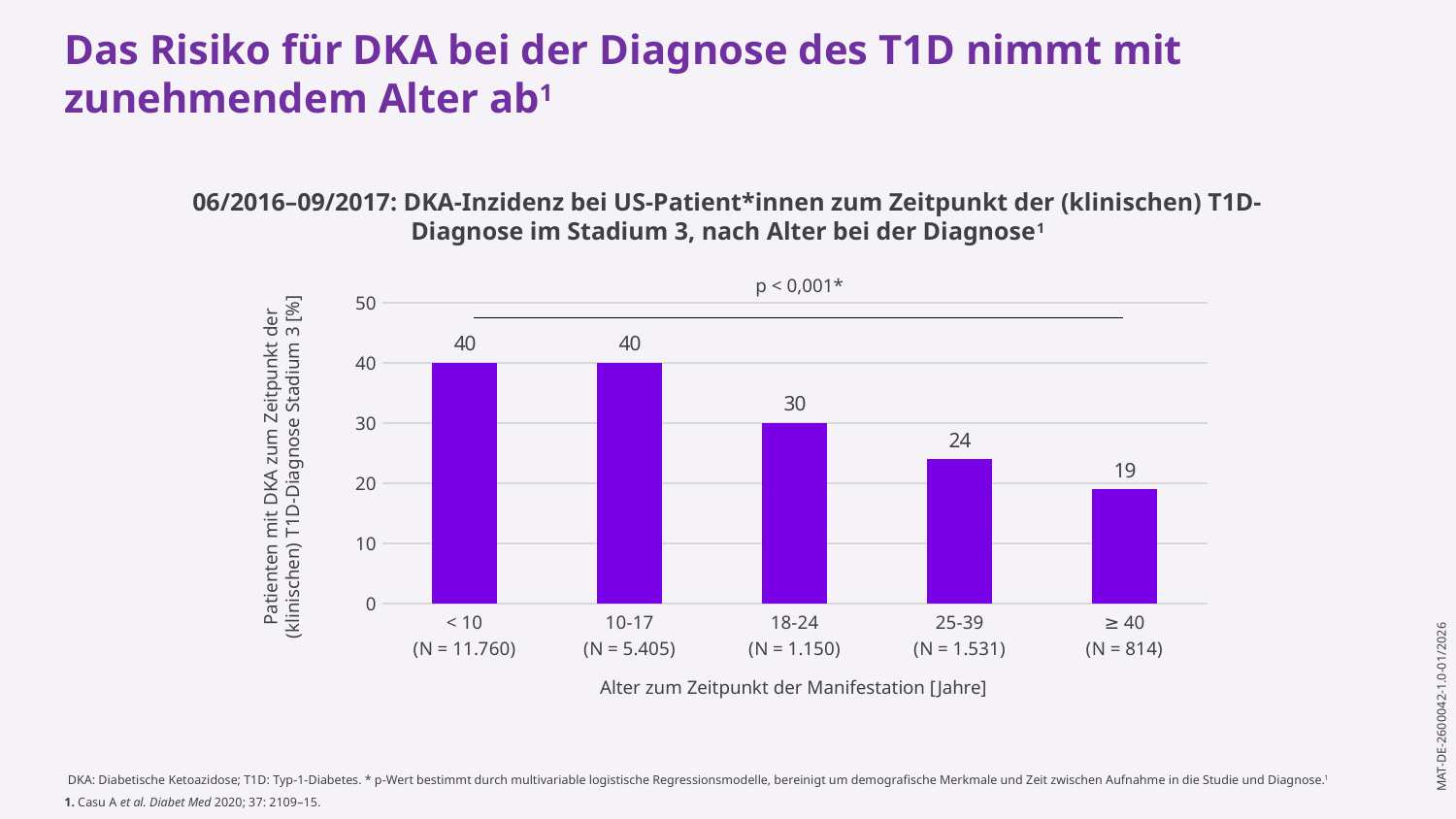
What is the difference between the values for the 18-24 and 25-39 age groups? 6 Which is larger, the value for 10-17 or the value for 18-24? 10-17 What is the value for the 25-39 age group? 24 Which age group has the lowest value? ≥ 40 Is the value for the 25-39 age group greater or less than 30? less Do the values rise or fall as age increases along the x axis? fall What is the value for the 18-24 age group? 30 What is the difference between the values for the < 10 and ≥ 40 age groups? 21 What is the value for the ≥ 40 age group? 19 What is the label of the x axis? Alter zum Zeitpunkt der Manifestation [Jahre] What kind of chart is shown on the slide? bar chart How many age groups are shown on the x axis? 5